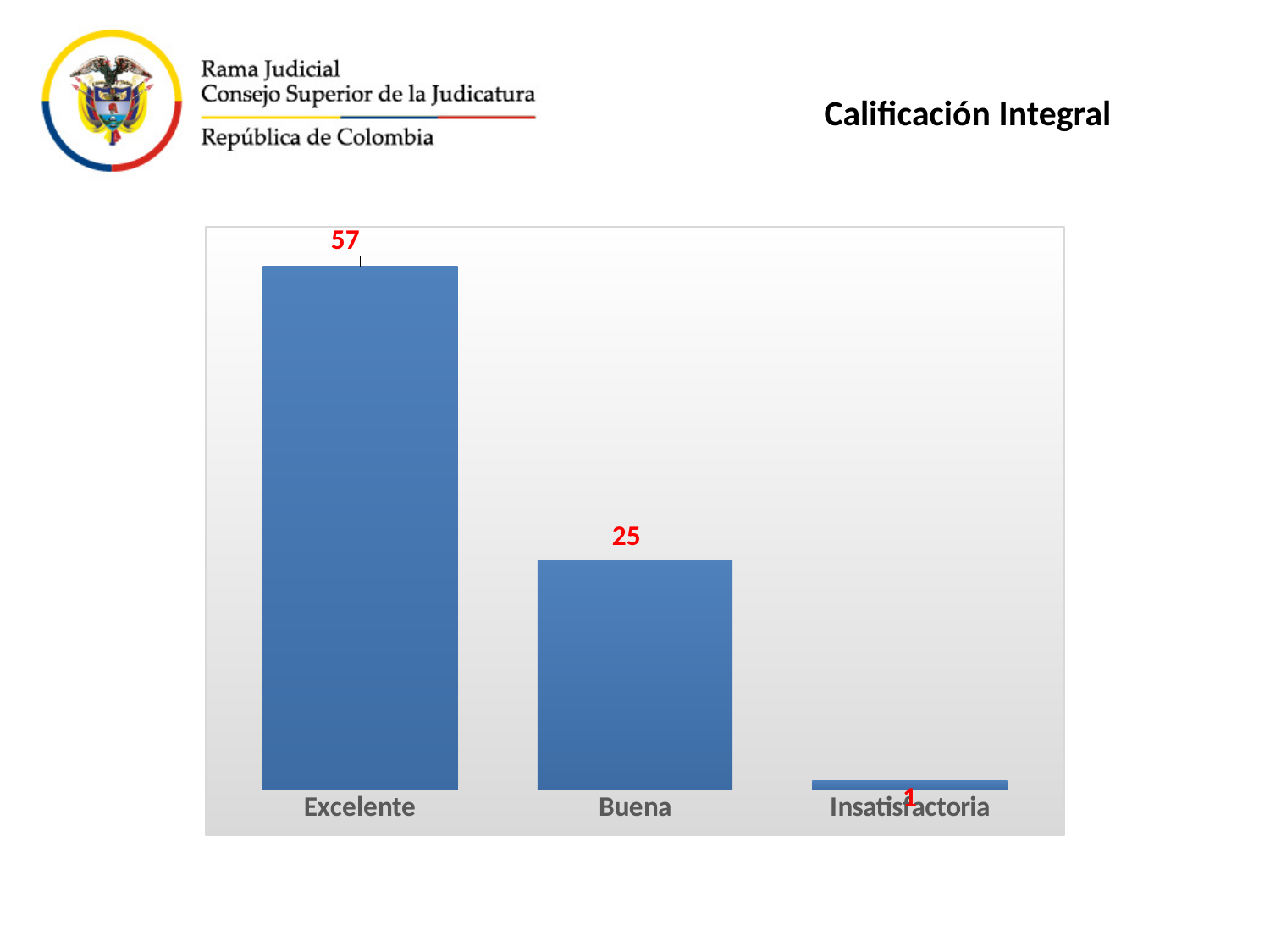
Do the values rise or fall from left to right across the categories? Fall What is the difference between the values for Buena and Insatisfactoria? 24 Which category has the lowest value? Insatisfactoria Which category has the highest value? Excelente What kind of chart is shown on the slide? Bar chart What is the value for Insatisfactoria? 1 What is the title shown above the chart? Calificación Integral How many categories are shown in the chart? 3 What is the value for Buena? 25 What is the difference between the values for Excelente and Buena? 32 What is the value for Excelente? 57 Which is larger, the value for Buena or the value for Insatisfactoria? Buena